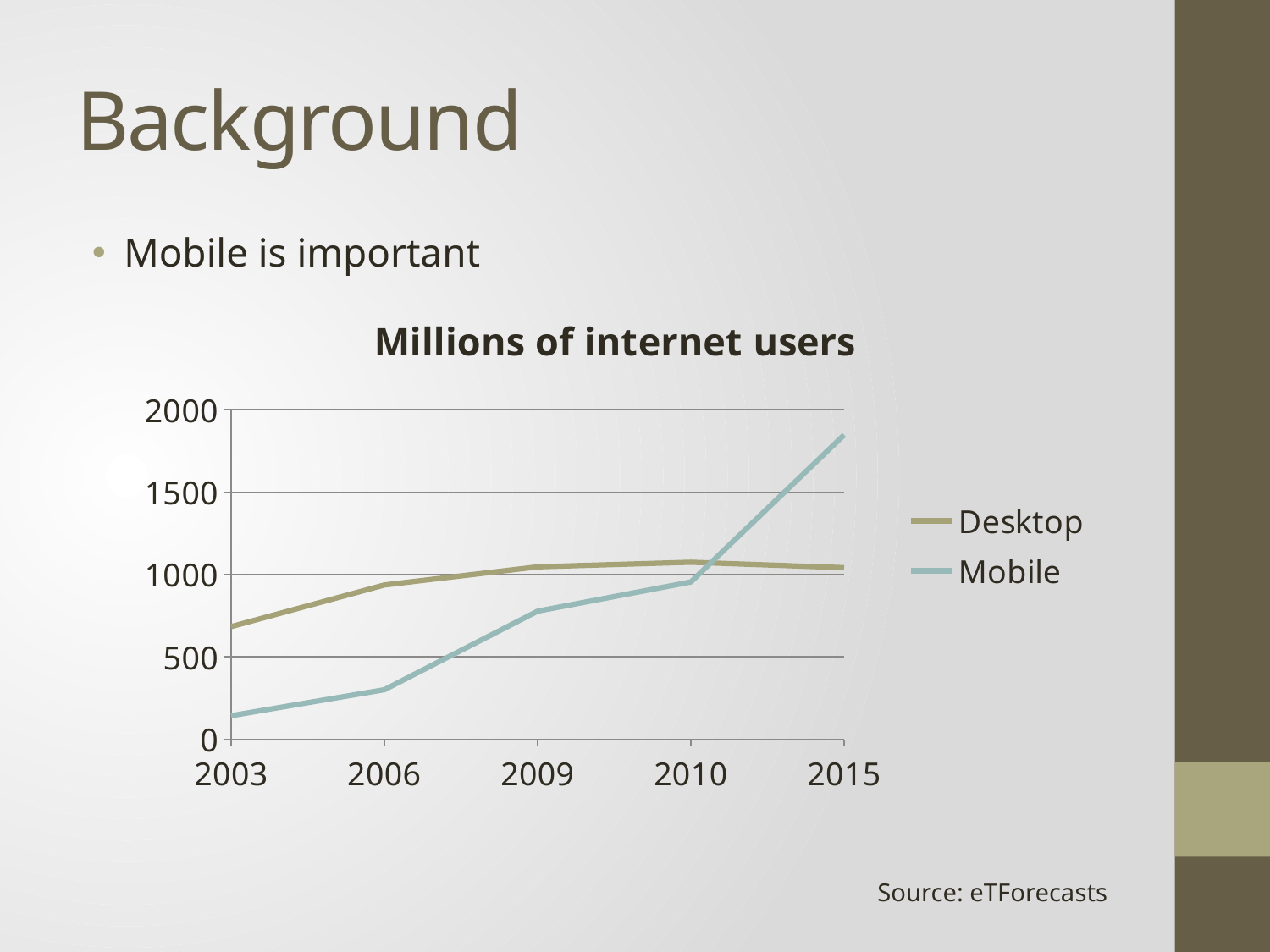
Is the value for Desktop in 2003 greater or less than 500? greater Is the value for Mobile in 2003 greater or less than 500? less How many years are shown on the x axis? 5 In which year does the Mobile series reach its highest value? 2015 In 2003, which series has the larger value, Desktop or Mobile? Desktop In 2015, which series has the larger value, Desktop or Mobile? Mobile Does the Mobile series rise or fall from 2003 to 2015? rise What kind of chart is shown on the slide? line chart Is the value for Mobile in 2015 greater or less than 1500? greater What is the title of the chart? Millions of internet users How many series does the legend list? 2